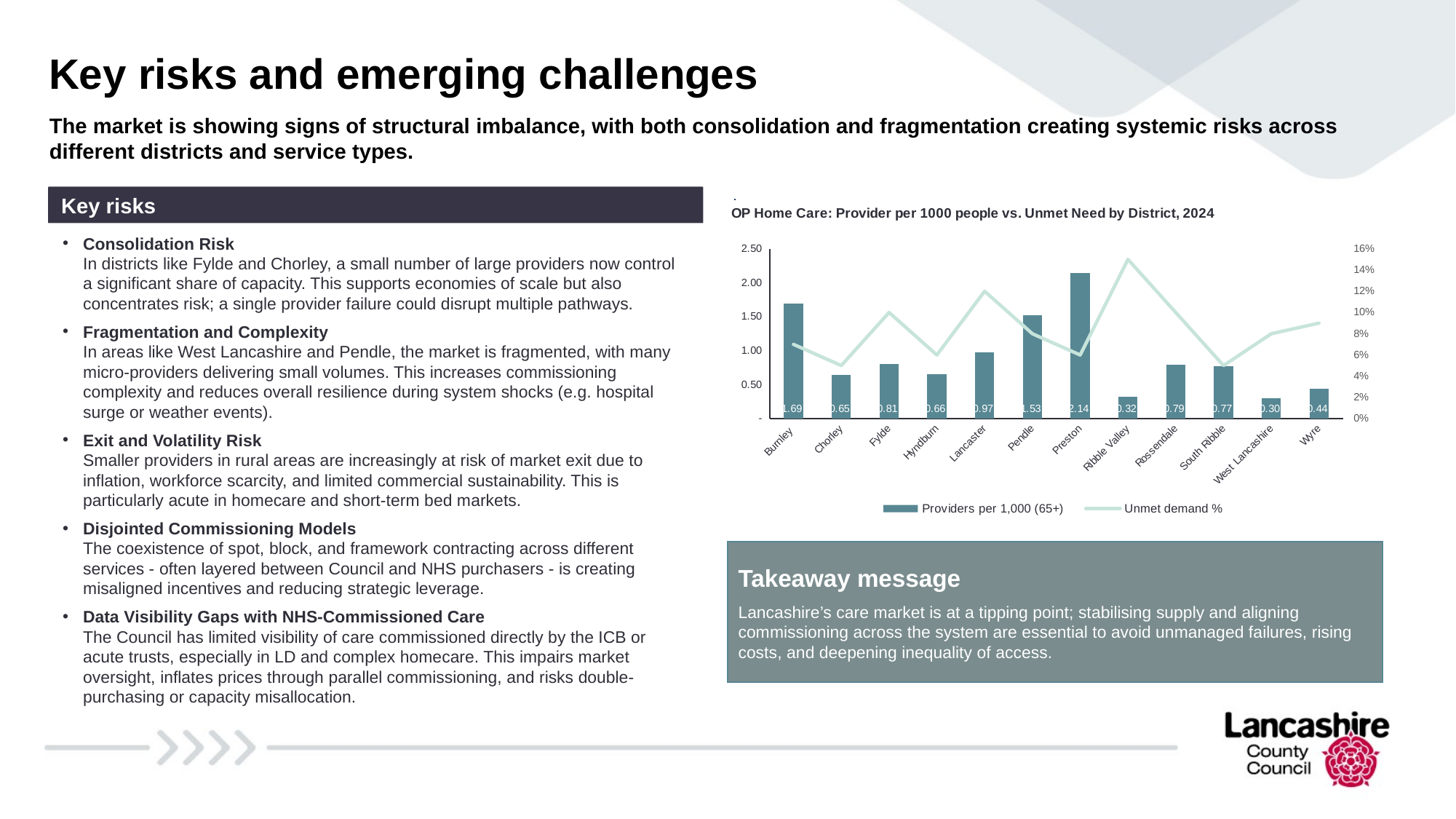
How many series does the chart legend list? 2 Which district has more Providers per 1,000 (65+), Pendle or Lancaster? Pendle Is the Unmet demand % for Ribble Valley greater or less than 12%? greater What is the difference in Providers per 1,000 (65+) between Preston and Burnley? 0.45 How many districts are shown on the x axis of the chart? 12 What kind of chart is shown on the slide? Combined bar and line chart What is the value of Providers per 1,000 (65+) for Hyndburn? 0.66 What is the value of Providers per 1,000 (65+) for Preston? 2.14 Which district has the lowest Providers per 1,000 (65+)? West Lancashire Is the Unmet demand % for Chorley greater or less than 8%? less What is the title of the chart? OP Home Care: Provider per 1000 people vs. Unmet Need by District, 2024 Which district has the highest Providers per 1,000 (65+)? Preston